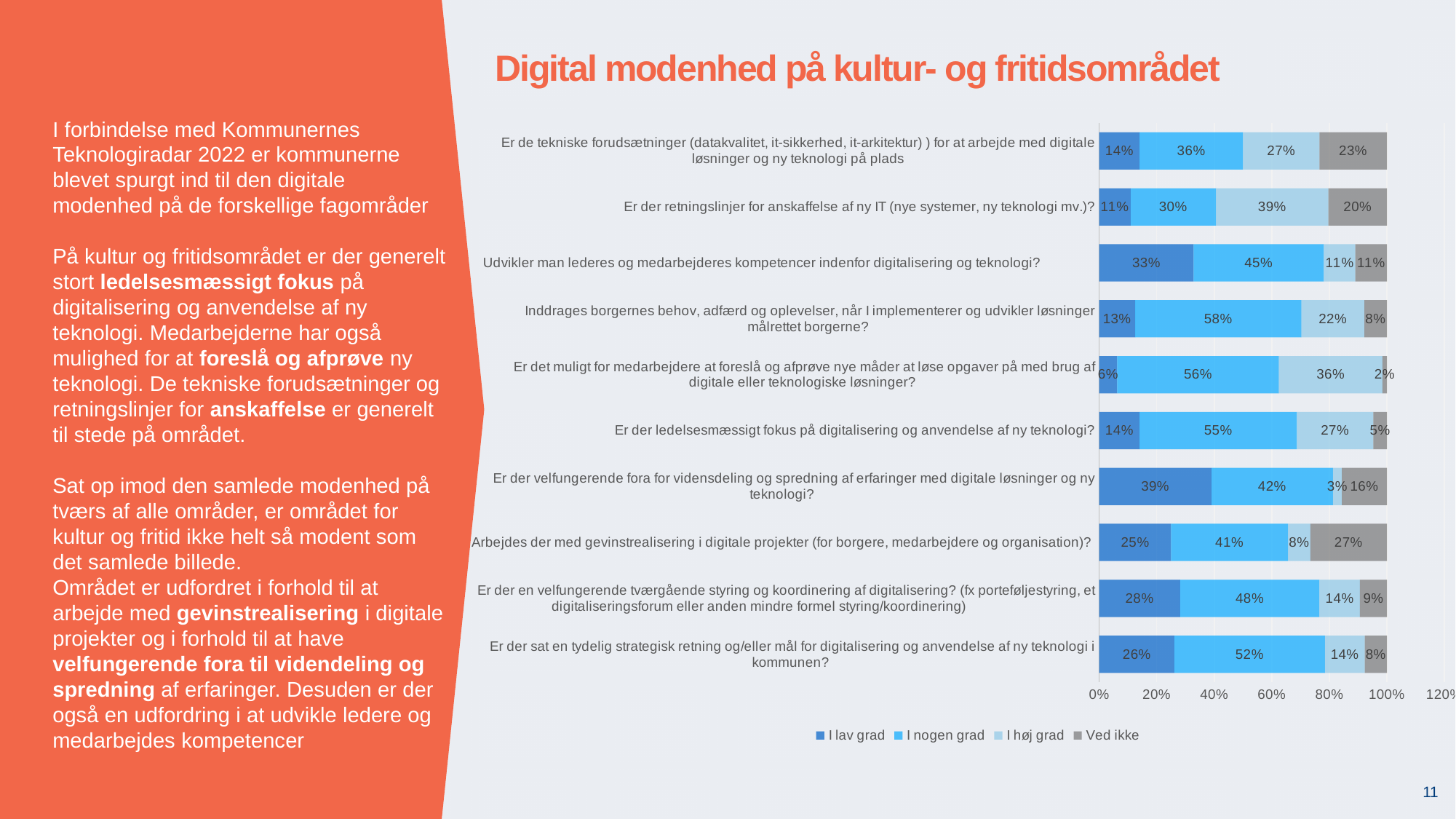
What kind of chart is shown on the slide? Stacked bar chart What is the total of the stacked bar for 'Er de tekniske forudsætninger (datakvalitet, it-sikkerhed, it-arkitektur) ) for at arbejde med digitale løsninger og ny teknologi på plads'? 100% What is the 'Ved ikke' value for 'Arbejdes der med gevinstrealisering i digitale projekter (for borgere, medarbejdere og organisation)?' 27% Which question has the highest 'I lav grad' value? Er der velfungerende fora for vidensdeling og spredning af erfaringer med digitale løsninger og ny teknologi? What is the title of the chart? Digital modenhed på kultur- og fritidsområdet What is the 'I nogen grad' value for 'Inddrages borgernes behov, adfærd og oplevelser, når I implementerer og udvikler løsninger målrettet borgerne?' 58% What is the 'I høj grad' value for 'Er der retningslinjer for anskaffelse af ny IT (nye systemer, ny teknologi mv.)?' 39% Which question has the lowest 'Ved ikke' value? Er det muligt for medarbejdere at foreslå og afprøve nye måder at løse opgaver på med brug af digitale eller teknologiske løsninger? How many questions (categories) are plotted in the chart? 10 What is the difference between the 'I nogen grad' value for 'Er der ledelsesmæssigt fokus på digitalisering og anvendelse af ny teknologi?' and the 'I nogen grad' value for 'Er der retningslinjer for anskaffelse af ny IT (nye systemer, ny teknologi mv.)?' 25% Which is larger: the 'I lav grad' value for 'Udvikler man lederes og medarbejderes kompetencer indenfor digitalisering og teknologi?' or the 'I lav grad' value for 'Er der sat en tydelig strategisk retning og/eller mål for digitalisering og anvendelse af ny teknologi i kommunen?' Udvikler man lederes og medarbejderes kompetencer indenfor digitalisering og teknologi? How many series does the legend list? 4